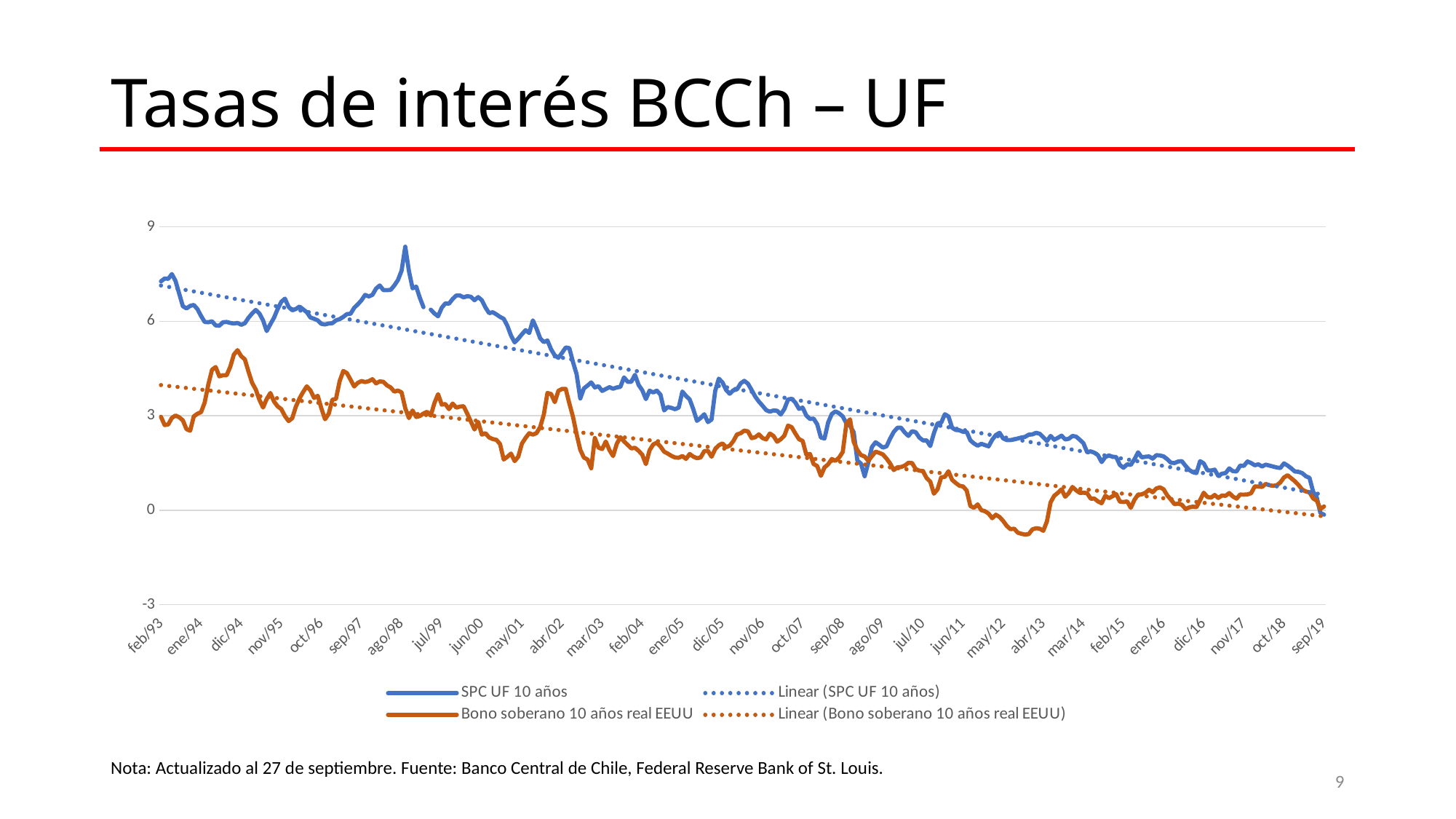
How many entries does the legend list? 4 Which series reaches the highest value anywhere on the chart? SPC UF 10 años Does the 'Bono soberano 10 años real EEUU' series generally rise or fall over the period shown? fall Is the value of 'Bono soberano 10 años real EEUU' around abr/13 greater or less than 0? less Which colour is used for the 'SPC UF 10 años' series? blue What is the title of the slide containing the chart? Tasas de interés BCCh – UF Does the 'SPC UF 10 años' series generally rise or fall from feb/93 to sep/19? fall How many labels are shown on the x axis? 30 What kind of chart is shown on the slide? line chart Is the value of 'SPC UF 10 años' at feb/93 greater or less than 6? greater At feb/93, which series has the higher value, 'SPC UF 10 años' or 'Bono soberano 10 años real EEUU'? SPC UF 10 años